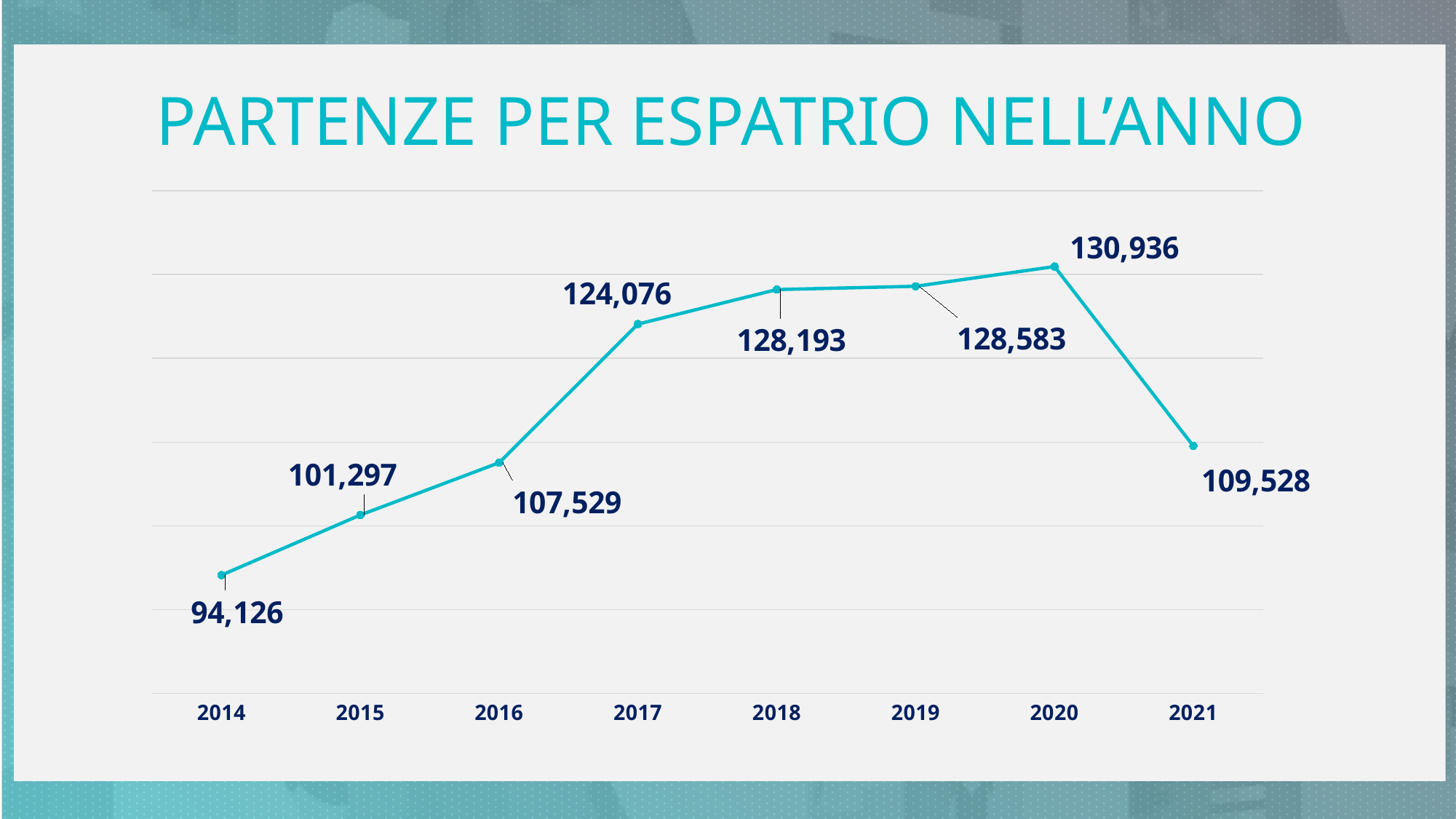
What kind of chart is shown on the slide? Line chart What is the difference between the values for 2020 and 2021? 21,408 What is the title of the chart? PARTENZE PER ESPATRIO NELL'ANNO How many years are plotted on the chart? 8 What is the difference between the values for 2015 and 2014? 7,171 What is the value for 2014? 94,126 Which is larger, the value for 2016 or the value for 2021? 2021 Which year has the highest value? 2020 What is the value for 2021? 109,528 What is the value for 2019? 128,583 Which year has the lowest value? 2014 What is the value for 2017? 124,076